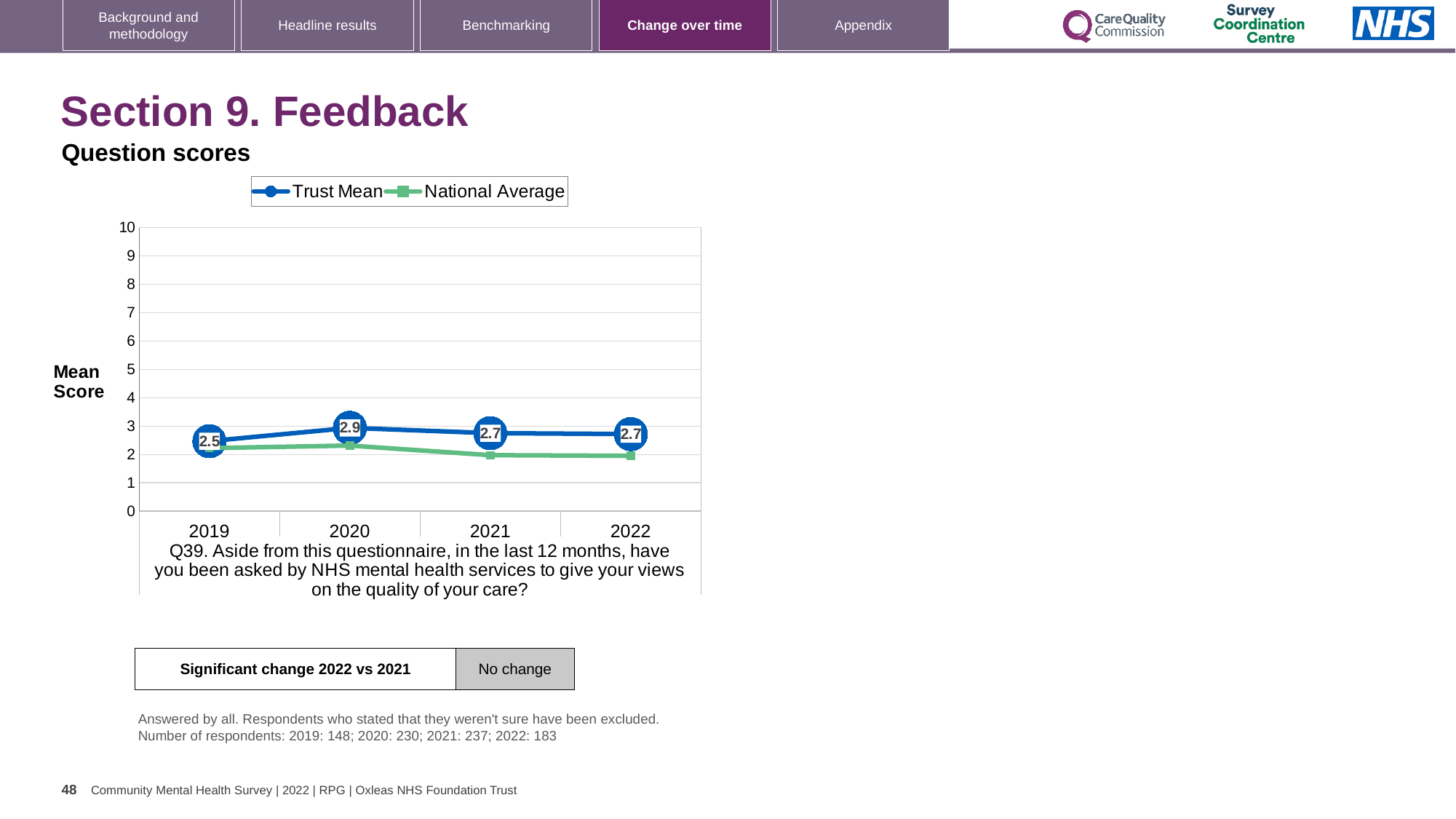
What is the Trust Mean score for 2020? 2.9 What kind of chart is shown on the slide? line chart Which is larger, the Trust Mean in 2020 or in 2021? 2020 In which year is the Trust Mean lowest? 2019 Is the National Average value for 2021 greater or less than 3? less What is the Trust Mean score for 2022? 2.7 In which year is the Trust Mean highest? 2020 Does the Trust Mean rise or fall from 2019 to 2020? rise What is the difference between the Trust Mean in 2020 and in 2019? 0.4 How many series does the legend list? 2 How many years are plotted on the x axis? 4 What is the Trust Mean score for 2019? 2.5